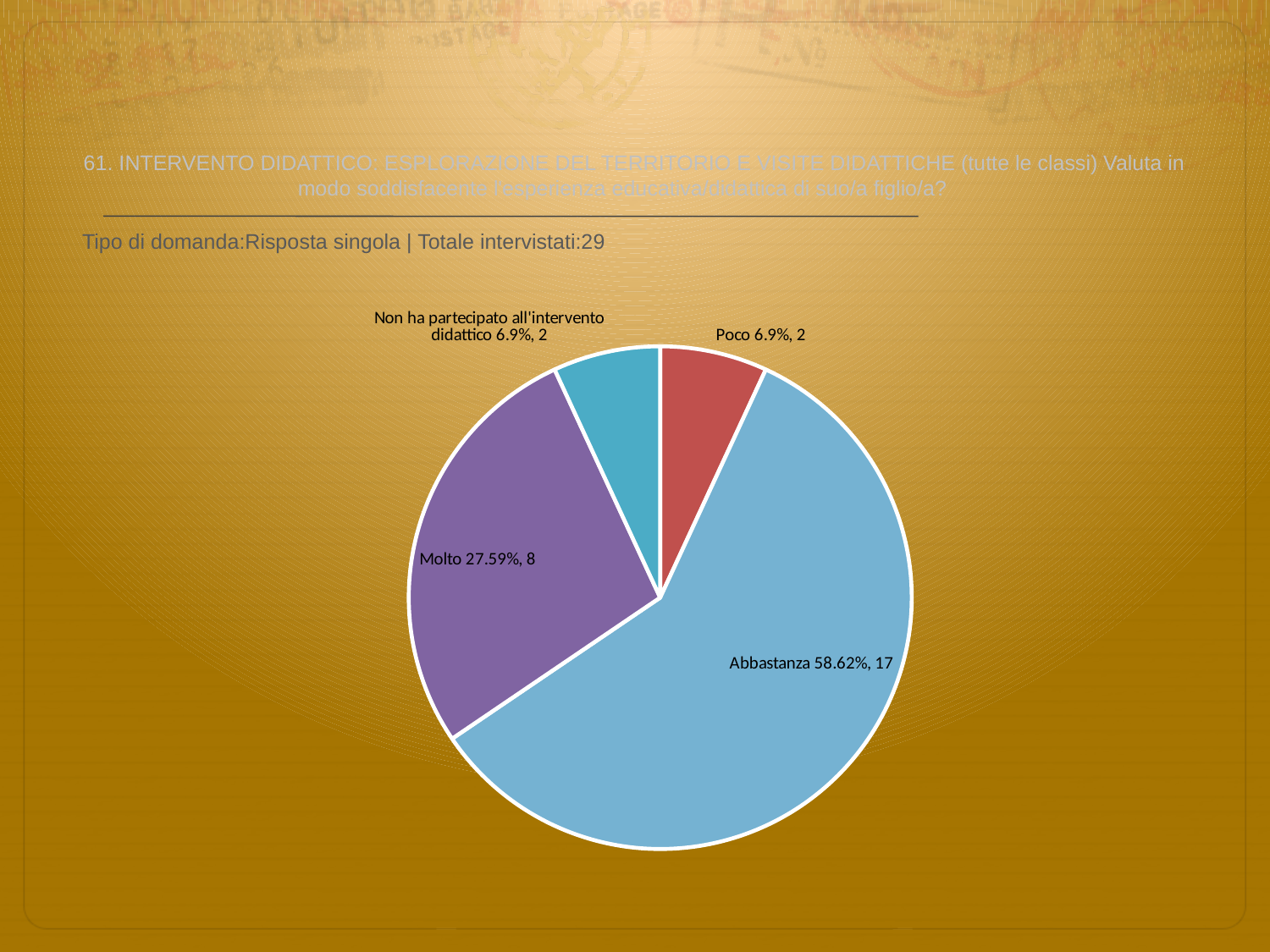
How many respondents answered Molto? 8 How many slices does the pie chart have? 4 What percentage share does the Abbastanza slice have? 58.62% What is the difference in count between Abbastanza and Molto? 9 What percentage share does the Molto slice have? 27.59% Which is larger, the Molto slice or the Poco slice? Molto What percentage is shown for 'Non ha partecipato all'intervento didattico'? 6.9% Which category has the largest slice? Abbastanza How many respondents answered Poco? 2 What is the total number of respondents stated on the slide? 29 What kind of chart is shown on the slide? pie chart What colour is the Abbastanza slice? light blue